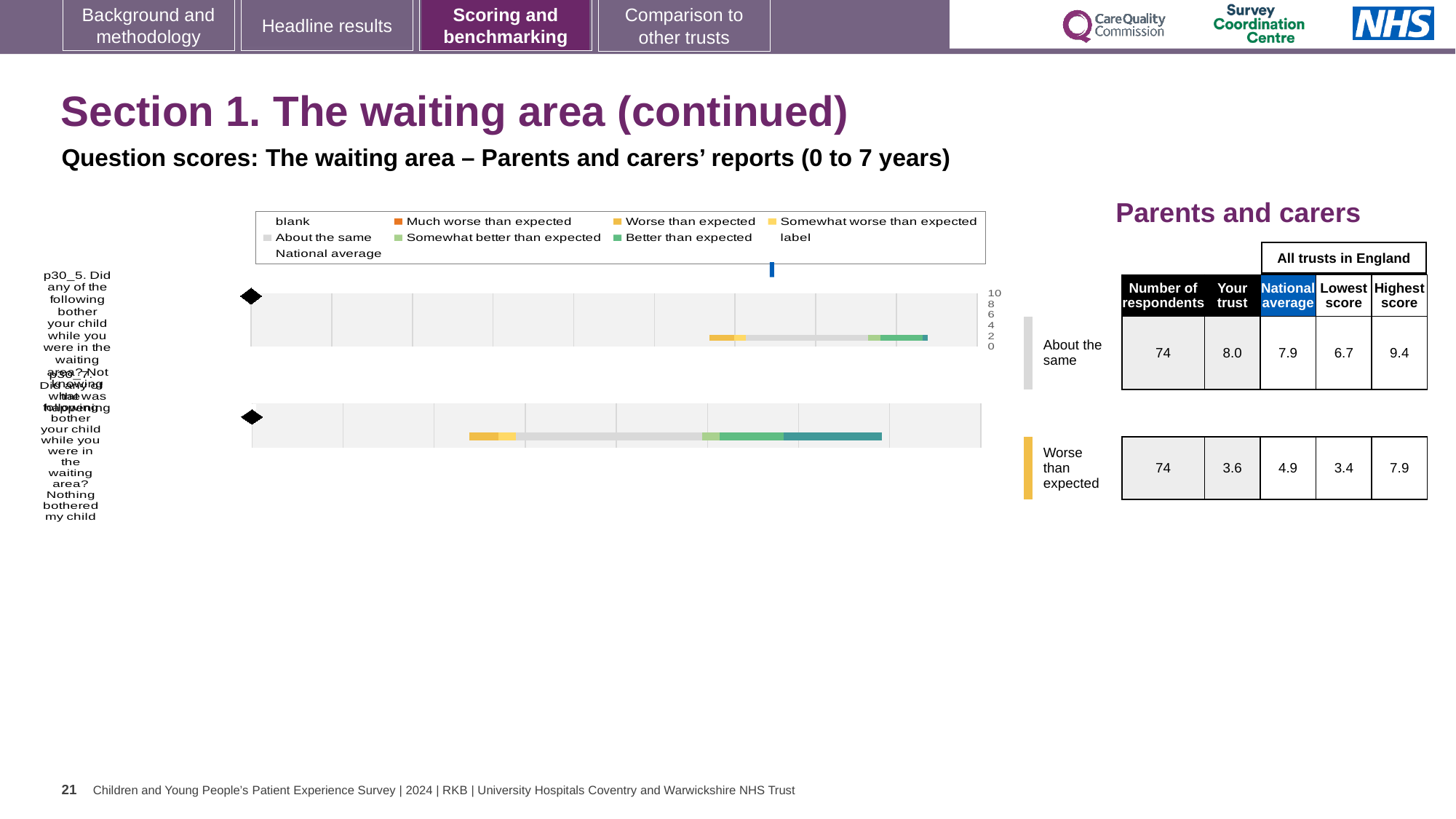
What is the difference between the national average and the trust's score for the question rated 'Worse than expected'? 1.3 What kind of chart is shown on the left of the slide? bar chart What is the difference between the highest and lowest scores in England for the question rated 'Worse than expected'? 4.5 What is the 'Your trust' score for the question rated 'About the same'? 8.0 How many respondents answered the question rated 'About the same'? 74 What is the 'Your trust' score for the question rated 'Worse than expected'? 3.6 For the question rated 'About the same', which is larger: the trust's score or the national average? Your trust How many question bars are plotted in the chart? 2 What is the highest score among all trusts in England for the question rated 'About the same'? 9.4 What is the national average for the question rated 'Worse than expected'? 4.9 Which legend entry is shown in orange? Much worse than expected How many entries does the chart legend list? 9